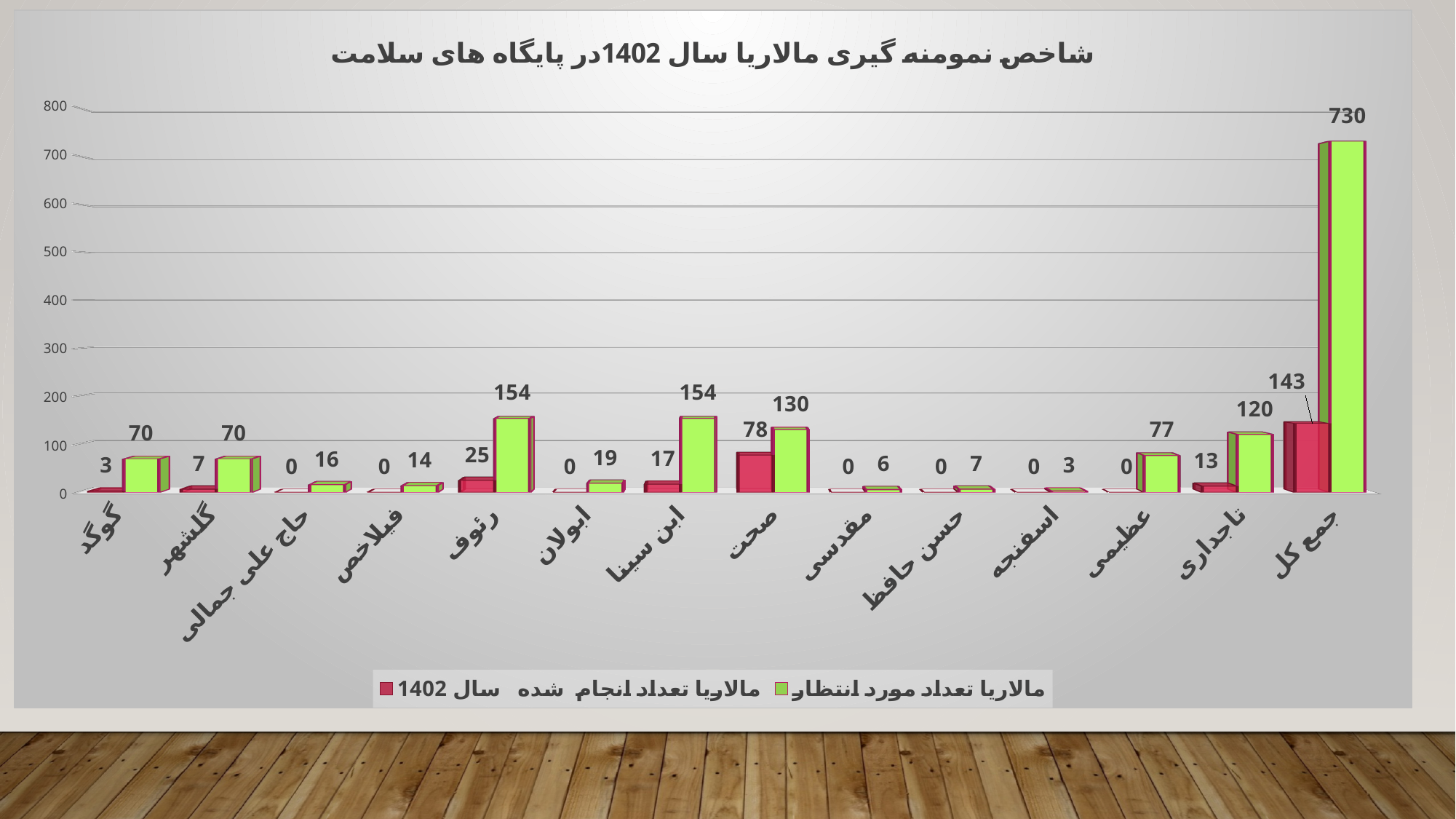
What is the expected number (مالاریا تعداد مورد انتظار) for صحت? 130 Which station has the lowest expected number (green series)? اسفنجه What is the difference between the expected number and the number performed in 1402 for صحت? 52 What is the difference between the expected number and the number performed for جمع کل? 587 What is the number performed in 1402 (مالاریا تعداد انجام شده سال 1402) for رئوف? 25 What is the expected number (مالاریا تعداد مورد انتظار) for تاجداری? 120 What is the number performed in 1402 for جمع کل? 143 How many series does the legend list? 2 Which is larger: the expected number for عظیمی or the expected number for گوگد? عظیمی Excluding جمع کل, which station has the highest number performed in 1402 (red series)? صحت What kind of chart is shown on the slide? Bar chart How many stations (categories) are shown on the x axis? 14